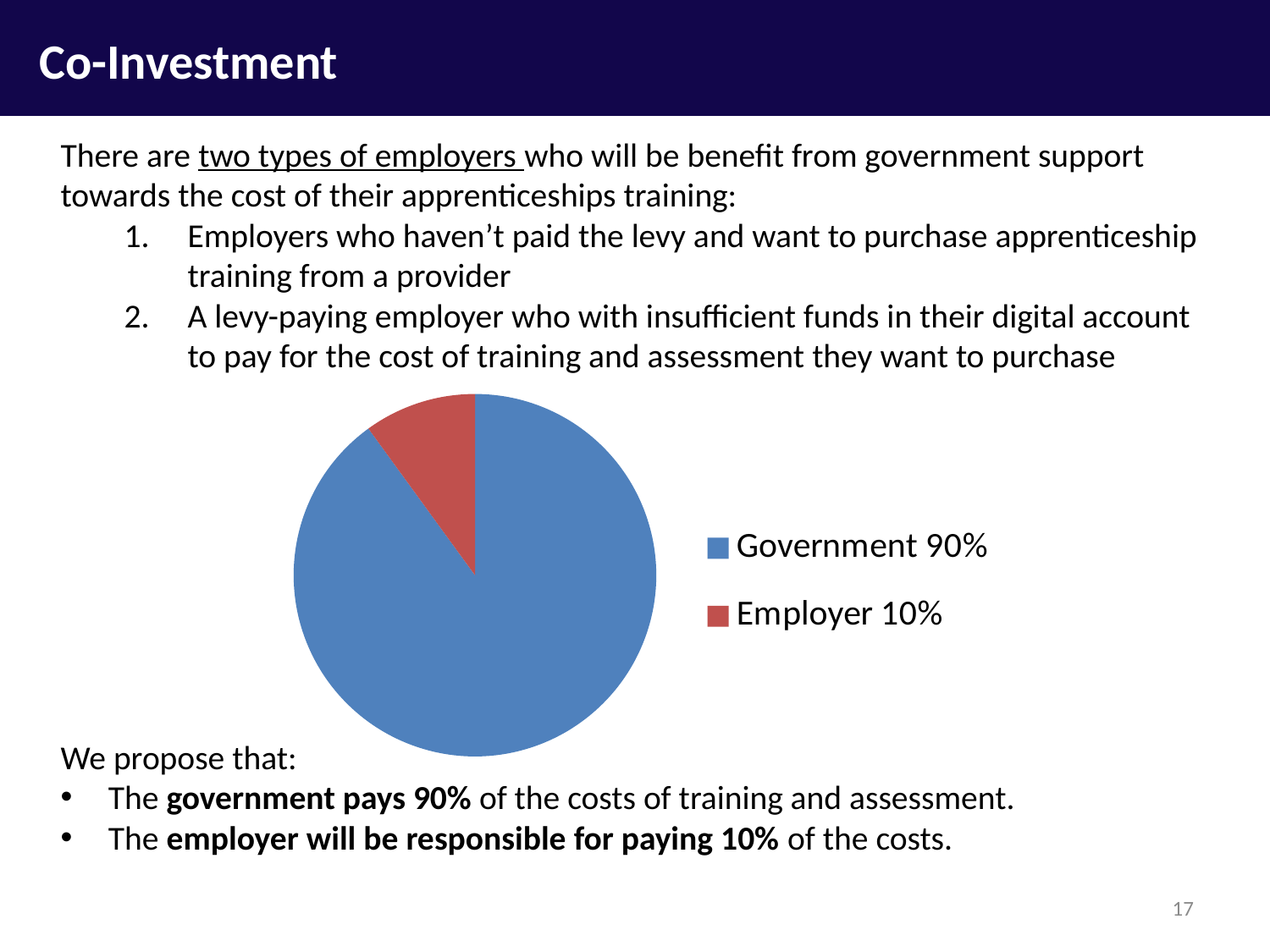
How many slices does the pie chart have? 2 What is the difference in percentage points between the Government share and the Employer share? 80% What share of the pie does the Employer slice represent? 10% Which slice of the pie chart is the smallest? Employer What share of the pie does the Government slice represent? 90% What kind of chart is shown on the slide? pie chart How many entries does the legend of the pie chart list? 2 Which slice of the pie chart is the largest? Government Which is larger in the pie chart, the Government share or the Employer share? Government What colour is the Employer slice in the pie chart? red What colour is the Government slice in the pie chart? blue